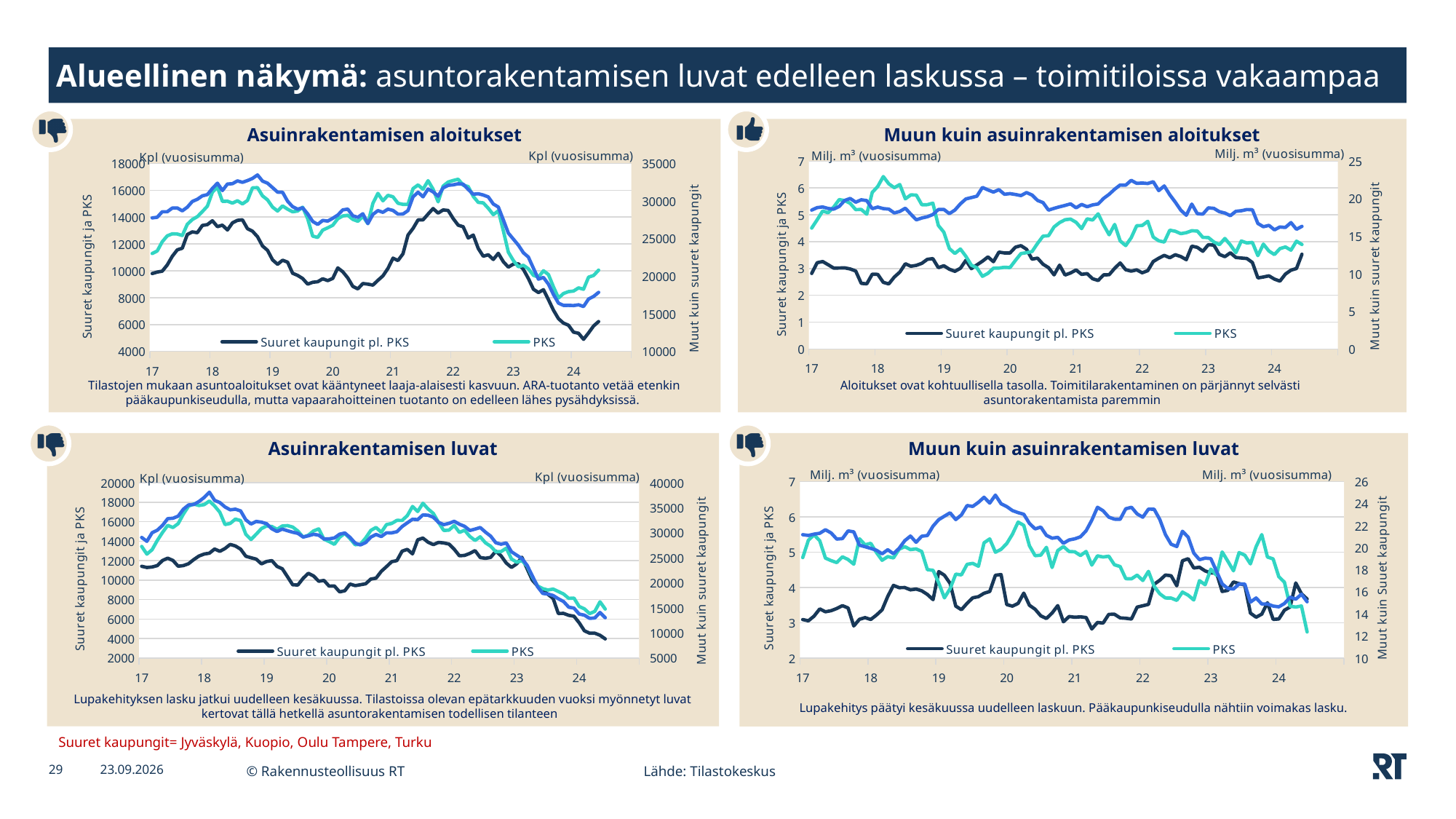
In the "Muun kuin asuinrakentamisen luvat" chart, what are the two legend entries? Suuret kaupungit pl. PKS and PKS In the "Muun kuin asuinrakentamisen aloitukset" chart, what unit is shown on the left axis label? Milj. m³ (vuosisumma) What kind of chart is "Asuinrakentamisen aloitukset"? Line chart How many charts are shown on the slide? 4 In the "Asuinrakentamisen aloitukset" chart, is the value for Suuret kaupungit pl. PKS at the end of the series (2024) greater or less than 8000? less In the "Muun kuin asuinrakentamisen luvat" chart, is the value for PKS at the end of the series (2024) greater or less than 3? less In the "Asuinrakentamisen luvat" chart, is the value for Suuret kaupungit pl. PKS at the end of the series (2024) greater or less than 6000? less In the "Asuinrakentamisen luvat" chart, does the Suuret kaupungit pl. PKS line rise or fall from 2022 to 2024? Fall In the "Asuinrakentamisen luvat" chart, how many series does the legend list? 2 In the "Asuinrakentamisen aloitukset" chart, does the PKS line rise or fall from 2022 to 2023? Fall